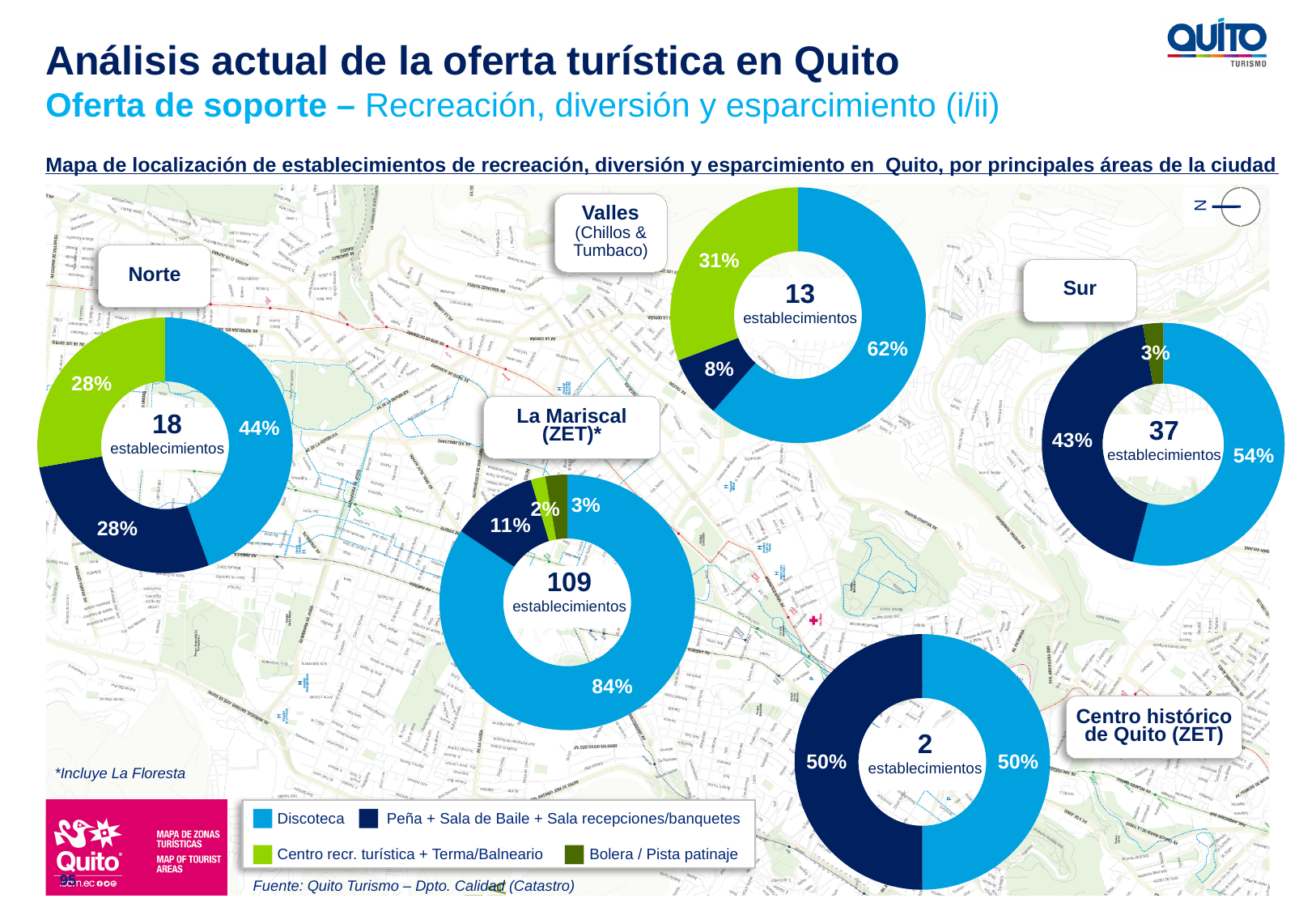
In the La Mariscal (ZET)* chart, which category has the largest share? Discoteca In the Valles (Chillos & Tumbaco) chart, what share is Centro recr. turística + Terma/Balneario? 31% In the Sur chart, which category has the smallest share? Bolera / Pista patinaje How many area charts are shown on the map? 5 Which area chart reports more establishments, Norte or Sur? Sur In the Centro histórico de Quito (ZET) chart, how many establishments are there? 2 establecimientos How many establishments does the La Mariscal (ZET)* chart report in total? 109 establecimientos What type of chart is used for each area on the slide? Donut (pie) chart How many categories does the legend list? 4 In the Sur chart, what share is Peña + Sala de Baile + Sala recepciones/banquetes? 43% In the Norte chart, what share of establishments are Discoteca? 44% In the Valles (Chillos & Tumbaco) chart, what is the difference between the Discoteca share and the Peña + Sala de Baile + Sala recepciones/banquetes share? 54%